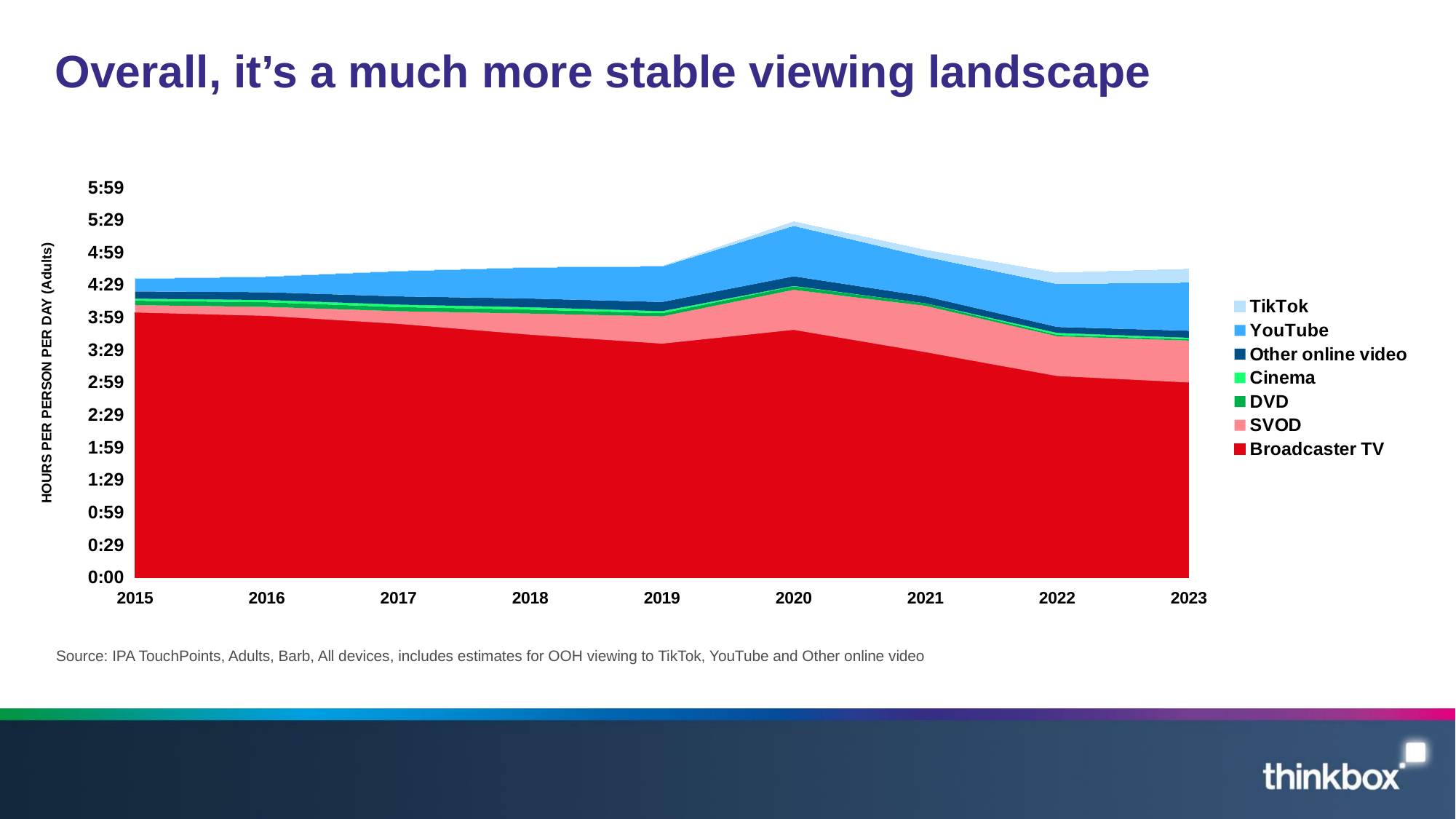
What is the title of the slide? Overall, it's a much more stable viewing landscape What is the label on the y axis? HOURS PER PERSON PER DAY (Adults) How many series does the legend list? 7 Which series accounts for the largest share of viewing in every year? Broadcaster TV Is the value for Broadcaster TV in 2020 greater or less than 3:29? greater Does Broadcaster TV viewing rise or fall from 2020 to 2023? fall How many years are plotted along the x axis? 9 Is the total viewing in 2020 greater or less than 4:59? greater What kind of chart is shown on the slide? Stacked area chart Is the total viewing in 2023 greater or less than 4:29? greater Which year has the highest total viewing hours per person per day? 2020